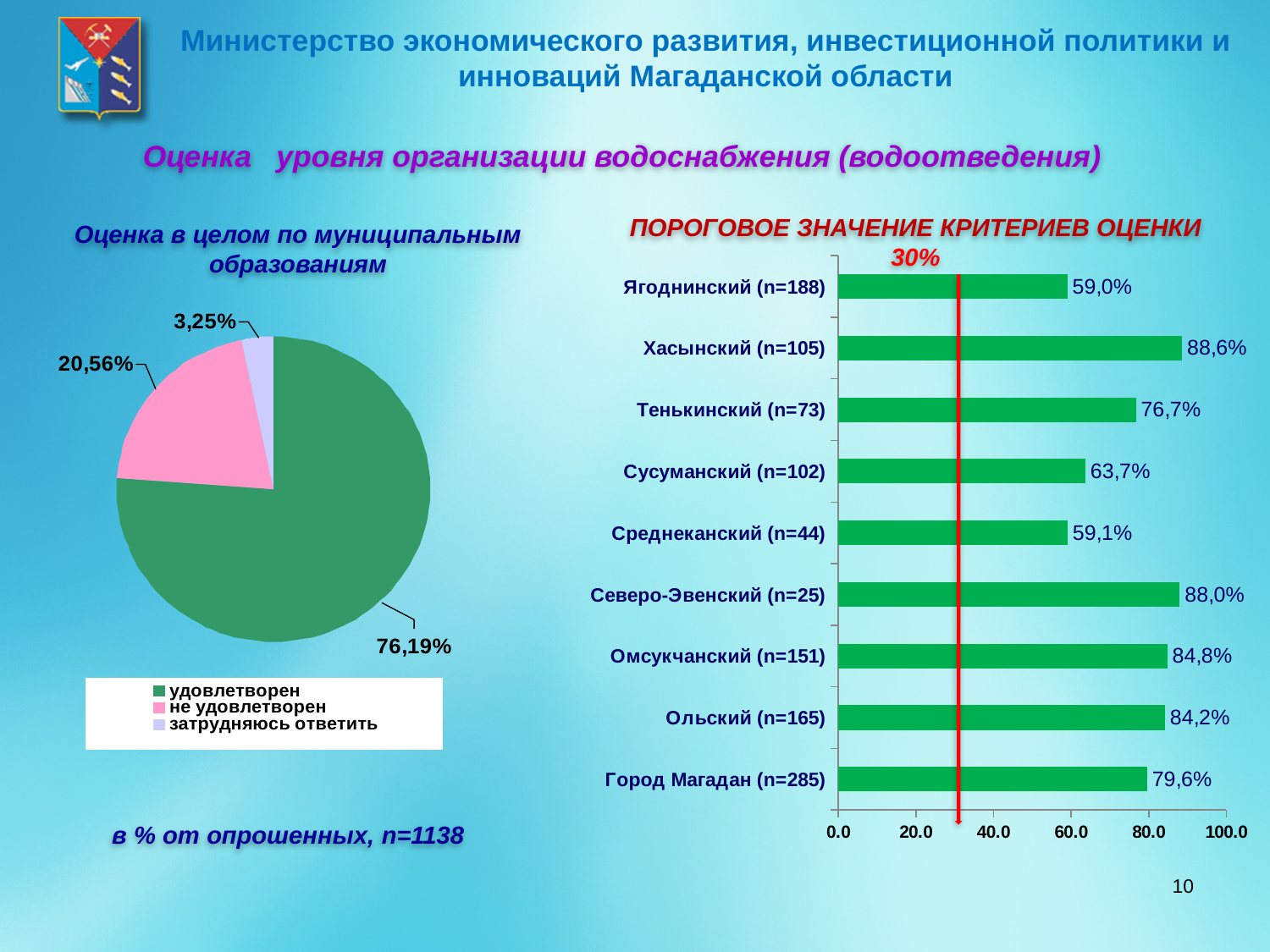
In the pie chart on the left, what share is labelled for 'не удовлетворен'? 20,56% In the bar chart on the right, which is larger: the value for Тенькинский (n=73) or Сусуманский (n=102)? Тенькинский (n=73) In the bar chart on the right, what is the value for Город Магадан (n=285)? 79,6% In the bar chart on the right, what is the value for Хасынский (n=105)? 88,6% How many entries does the legend of the pie chart on the left list? 3 What type of chart is on the right side of the slide? bar chart In the bar chart on the right, how many municipalities are shown? 9 In the pie chart on the left, what is the value of the smallest slice? 3,25% What type of chart is on the left side of the slide? pie chart In the pie chart on the left, what share is labelled for 'удовлетворен'? 76,19% In the bar chart on the right, which municipality has the highest value? Хасынский (n=105) In the bar chart on the right, what is the difference between the values for Омсукчанский (n=151) and Ольский (n=165)? 0,6%